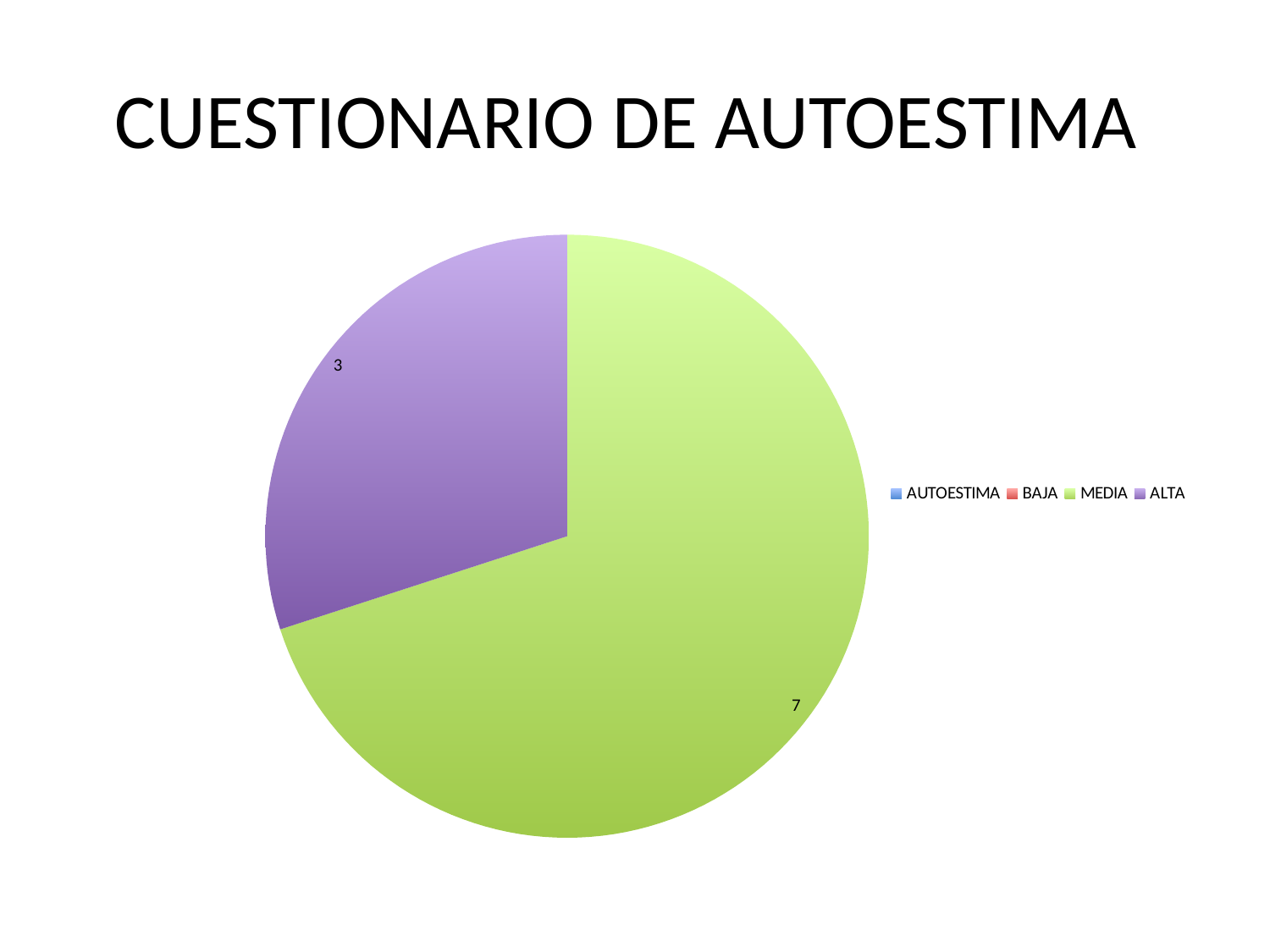
Which slice of the pie is the largest? MEDIA How many slices are visible in the pie? 2 What share of the pie does the MEDIA slice represent? 70% What is the total of the values shown on the pie slices? 10 What kind of chart is shown on the slide? pie chart What is the value of the MEDIA slice? 7 What is the difference between the MEDIA value and the ALTA value? 4 What share of the pie does the ALTA slice represent? 30% Which is larger, the MEDIA slice or the ALTA slice? MEDIA What is the value of the ALTA slice? 3 What is the title of the slide? CUESTIONARIO DE AUTOESTIMA How many entries does the legend list? 4